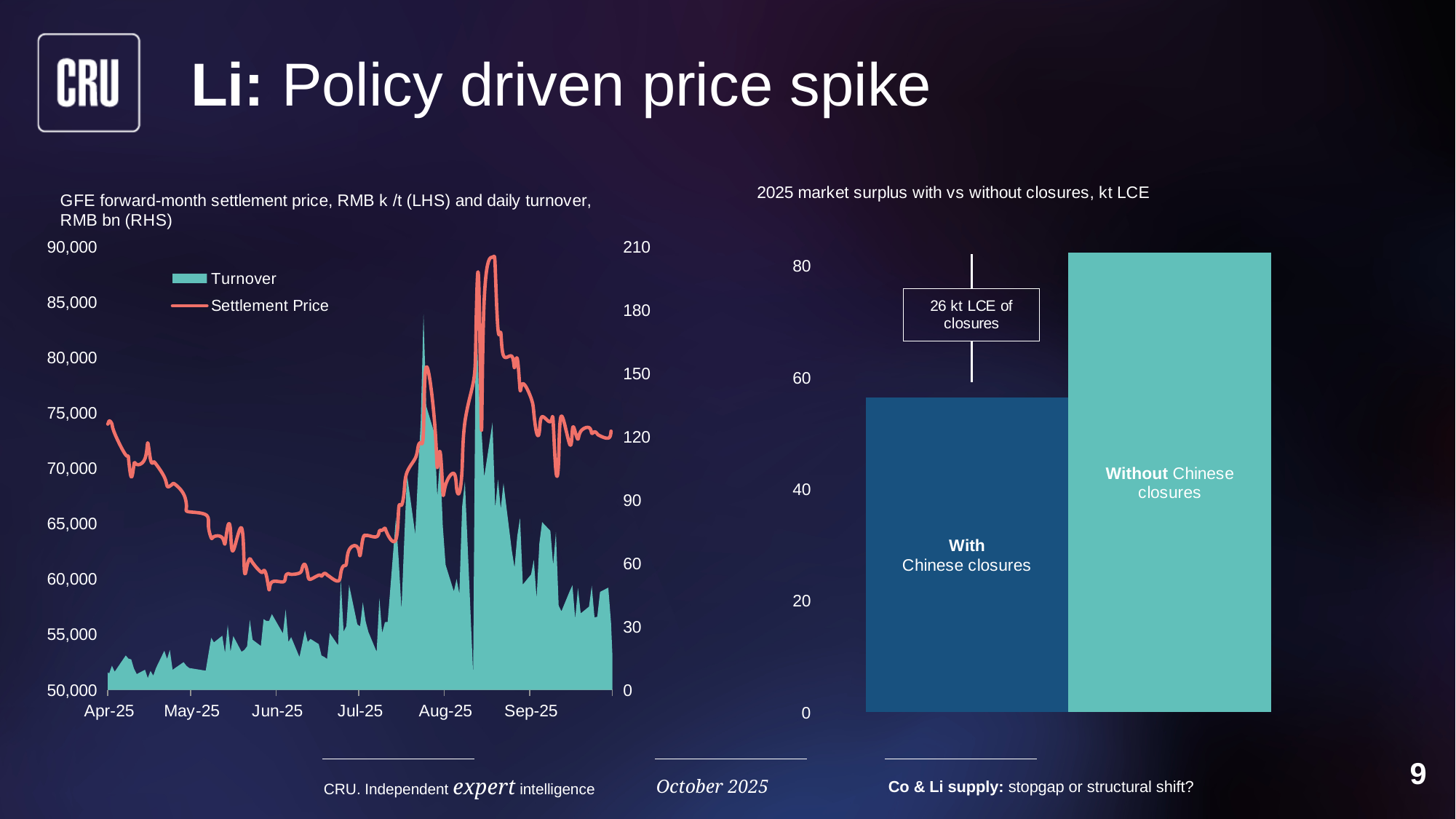
On the left chart, is the settlement price at the start of Apr-25 greater or less than 70,000? greater On the left chart, what are the two series named in the legend? Turnover and Settlement Price On the left chart, is the settlement price in mid Jun-25 greater or less than 65,000? less On the left chart, does the settlement price rise or fall from Apr-25 to Jun-25? fall On the left chart, is the peak of the settlement price greater or less than 85,000? greater On the right chart, how many bars are plotted? 2 What kind of chart is the right-hand chart titled '2025 market surplus with vs without closures, kt LCE'? bar chart On the left chart, how many series does the legend list? 2 On the right chart, which bar is higher: 'With Chinese closures' or 'Without Chinese closures'? Without Chinese closures On the left chart, what is the first month label shown on the x axis? Apr-25